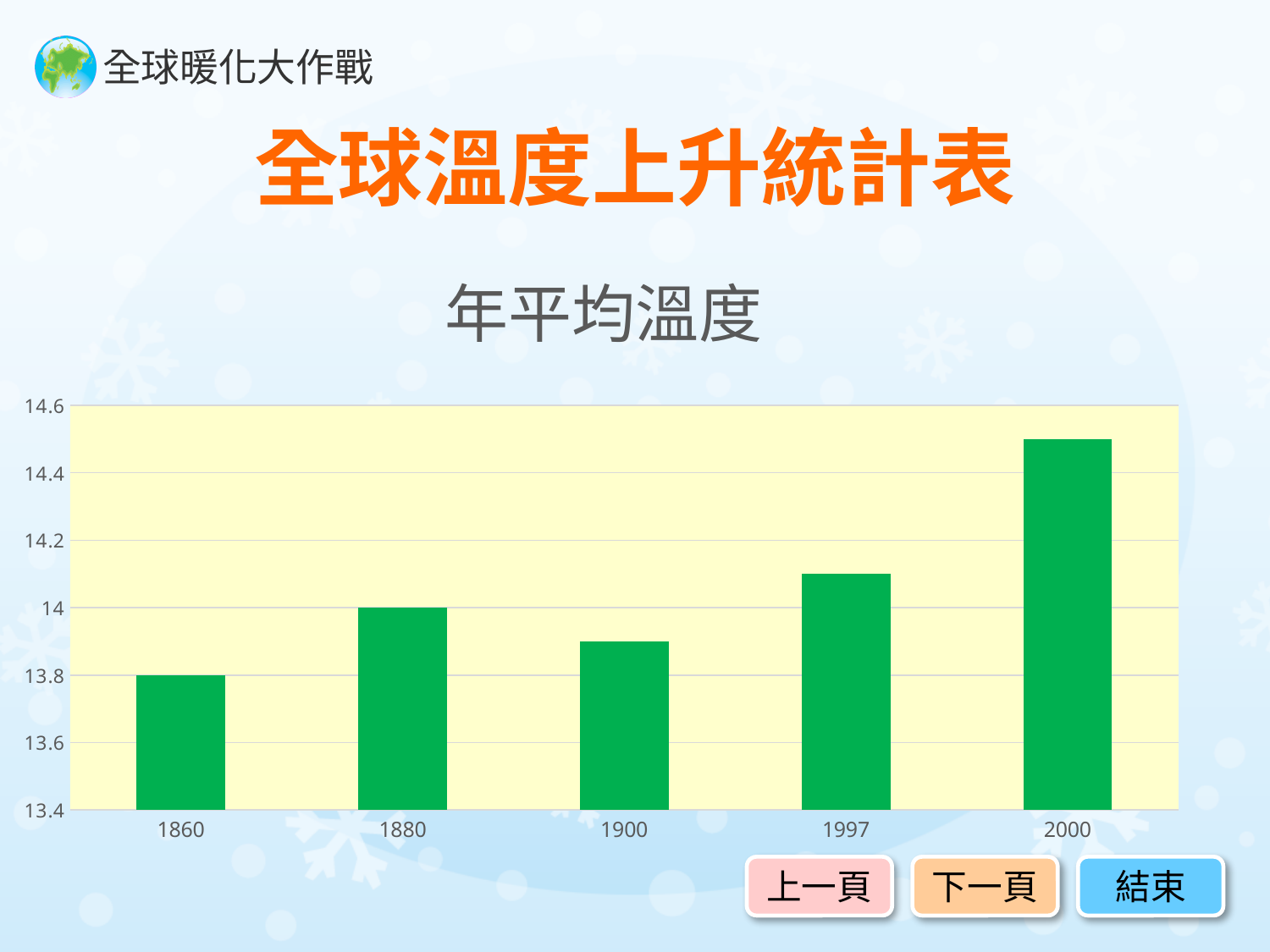
Is the value for 2000 greater or less than 14.4? greater Which year has the highest value in the chart? 2000 Which year has the lowest value in the chart? 1860 Which has the larger value, 1880 or 1900? 1880 What is the value for 1860 in the 年平均溫度 chart? 13.8 What kind of chart is shown on the slide? bar chart What is the title of the chart? 年平均溫度 What is the difference between the values for 1880 and 1860? 0.2 Is the value for 1900 greater or less than 14? less How many years are shown on the x axis of the chart? 5 Is the value for 1997 greater or less than 14? greater What is the value for 1880 in the 年平均溫度 chart? 14